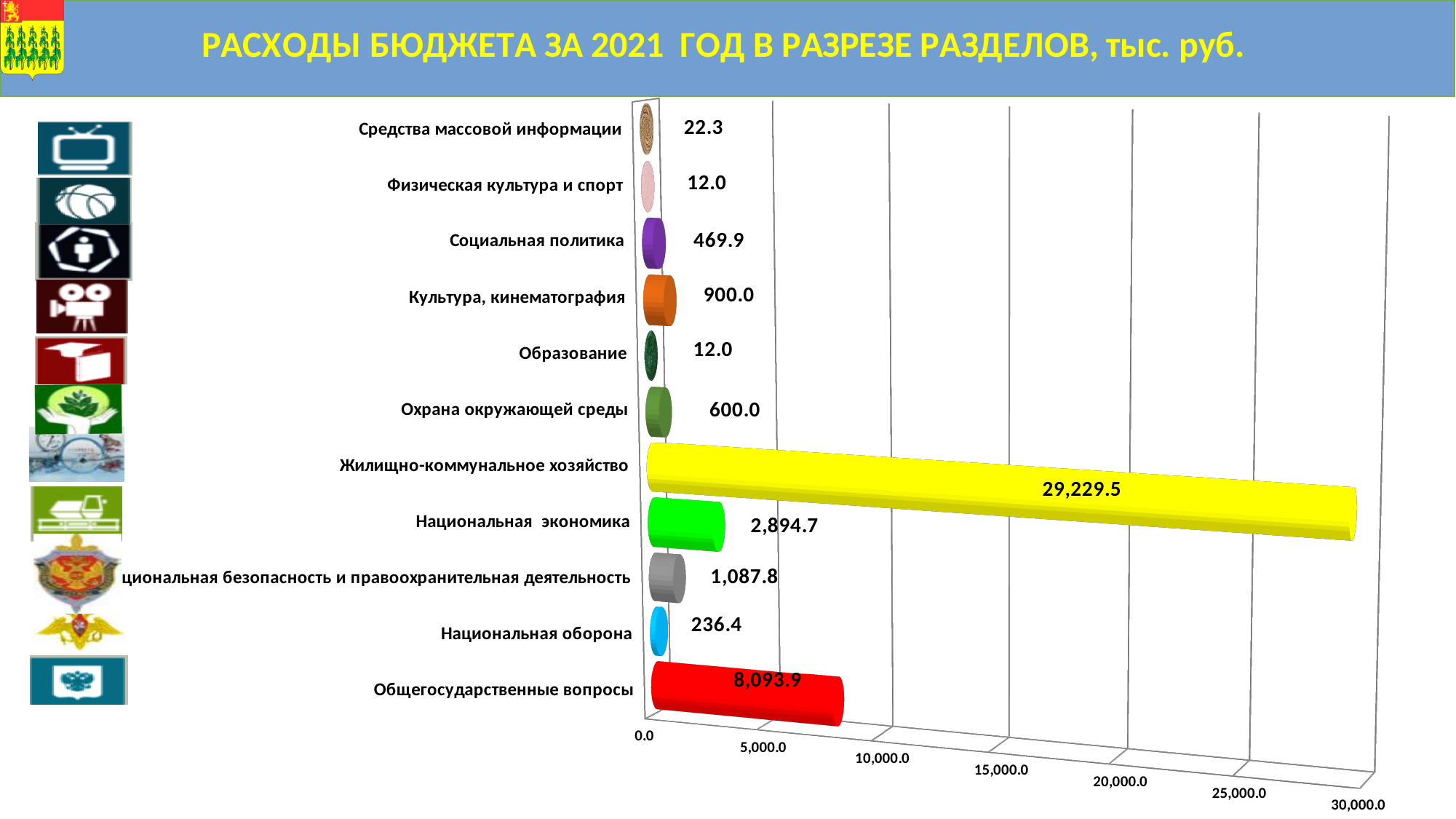
What is the title of the slide? РАСХОДЫ БЮДЖЕТА ЗА 2021 ГОД В РАЗРЕЗЕ РАЗДЕЛОВ, тыс. руб. Which is larger, the value for Национальная экономика or the value for Национальная оборона? Национальная экономика How many categories are shown in the chart? 11 What is the value for Национальная оборона? 236.4 What is the value for Социальная политика? 469.9 Which category has the highest value? Жилищно-коммунальное хозяйство What is the difference between the values for Культура, кинематография and Охрана окружающей среды? 300.0 What is the difference between the values for Жилищно-коммунальное хозяйство and Общегосударственные вопросы? 21,135.6 What is the value for Национальная экономика? 2,894.7 What is the value for Жилищно-коммунальное хозяйство? 29,229.5 What is the value for Общегосударственные вопросы? 8,093.9 What type of chart is shown on the slide? Bar chart